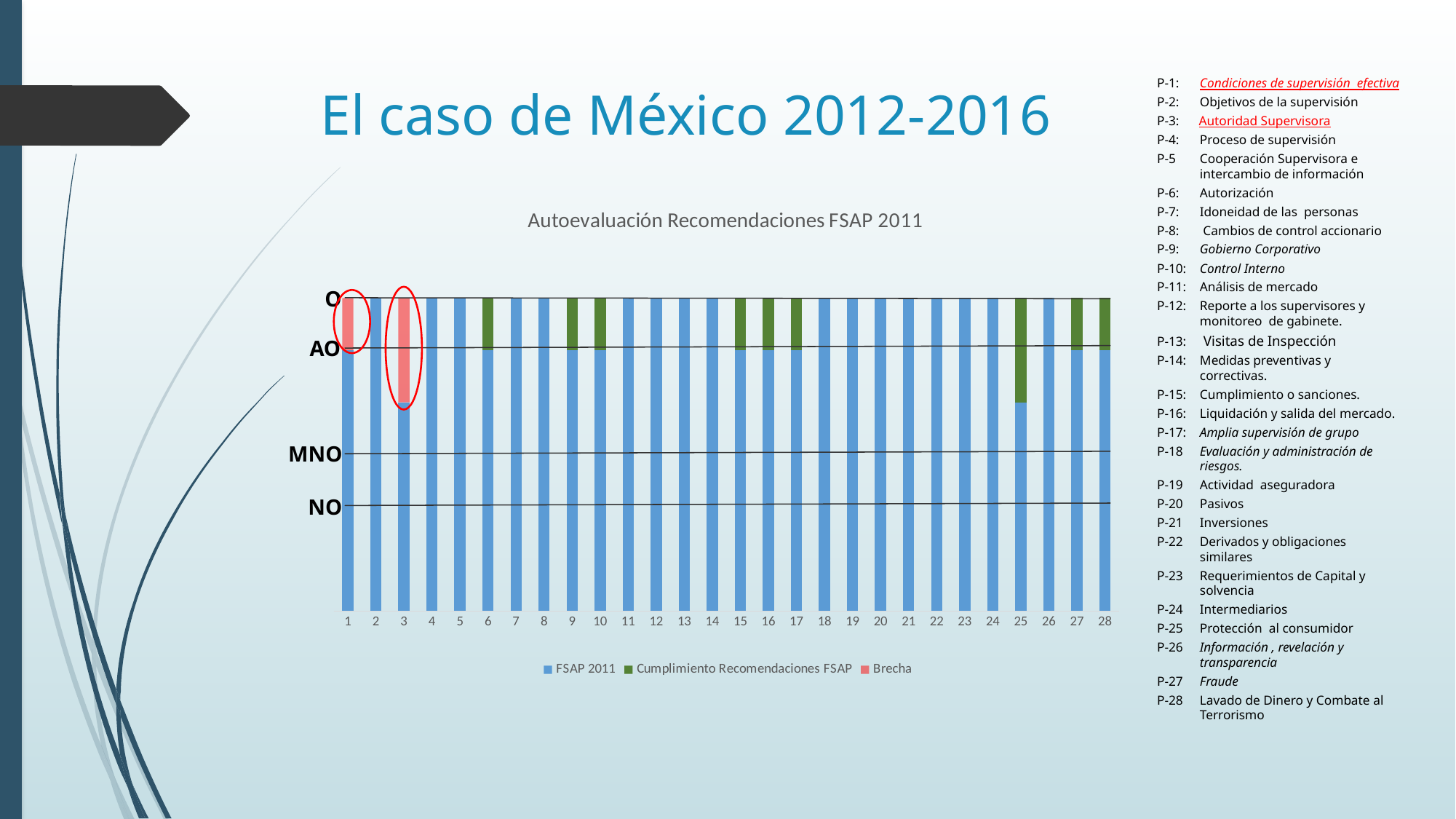
Which series in the legend is shown in red? Brecha How many series does the chart legend list? 3 Does the blue (FSAP 2011) bar for category 25 reach the AO line or stop below it? below What is the title of the chart? Autoevaluación Recomendaciones FSAP 2011 Which category has the largest green (Cumplimiento Recomendaciones FSAP) segment? 25 Which categories on the x axis have a red (Brecha) segment in their bar? 1 and 3 What kind of chart is shown on the slide? bar chart Which category has the largest red (Brecha) segment? 3 How many categories are shown along the x axis of the chart? 28 What is the lowest label on the y axis of the chart? NO Does the blue (FSAP 2011) bar for category 2 reach the O line? yes Which is larger, the green segment for category 25 or the green segment for category 6? category 25